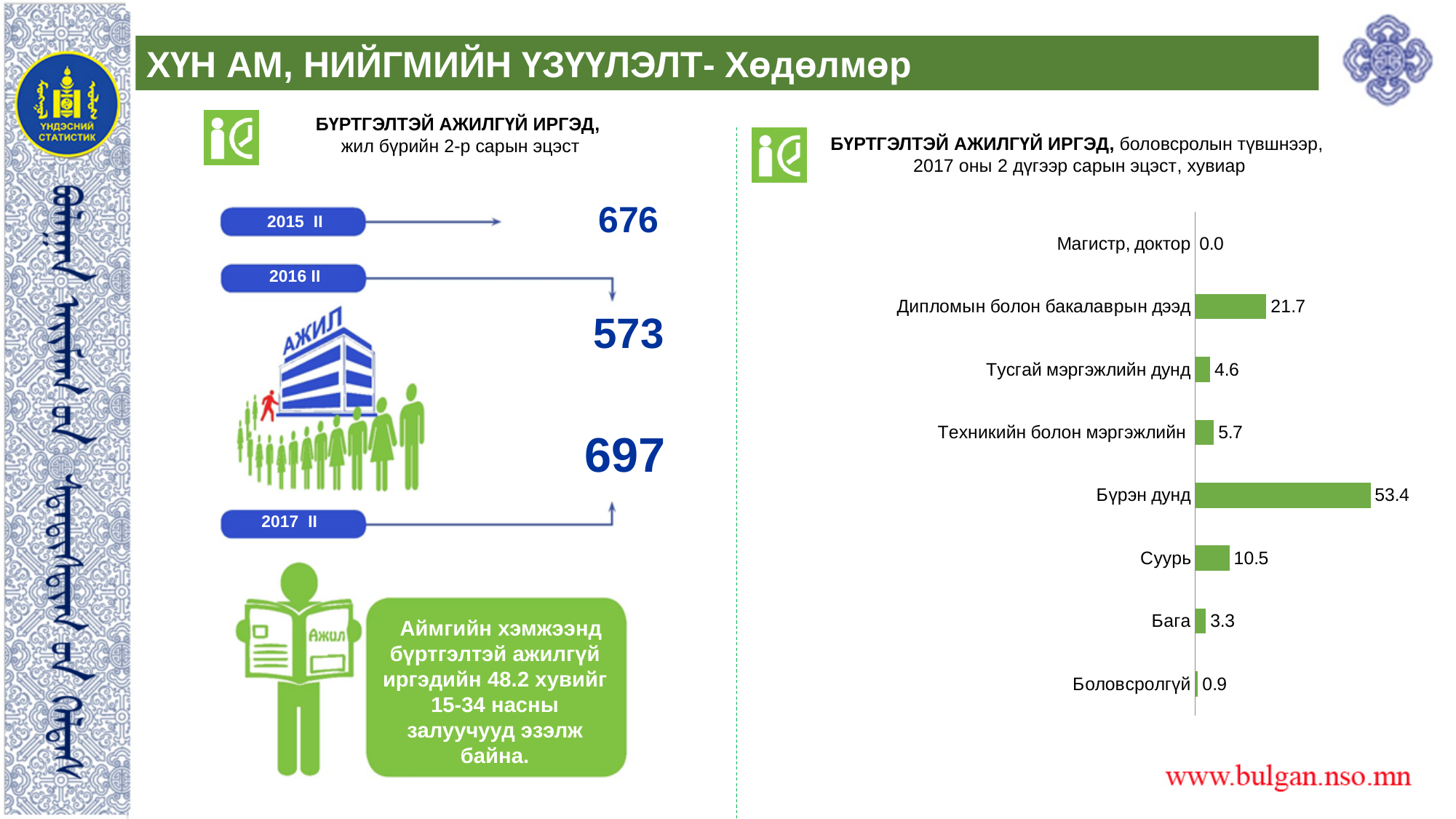
In the infographic on the left, what is the number of registered unemployed citizens shown for 2017 II? 697 In the bar chart on the right, what is the value for Бүрэн дунд? 53.4 In the bar chart on the right, what is the value for Боловсролгүй? 0.9 In the infographic on the left, what is the difference between the values for 2015 II and 2016 II? 103 In the bar chart on the right, what is the value for Суурь? 10.5 In the bar chart on the right, which category has the highest value? Бүрэн дунд What kind of chart is shown on the right side of the slide? Bar chart In the bar chart on the right, what is the value for Дипломын болон бакалаврын дээд? 21.7 In the bar chart on the right, which is larger: the value for Суурь or the value for Техникийн болон мэргэжлийн? Суурь In the bar chart on the right, what is the difference between the values for Бүрэн дунд and Дипломын болон бакалаврын дээд? 31.7 How many categories are shown in the bar chart on the right? 8 In the bar chart on the right, which category has the lowest value? Магистр, доктор